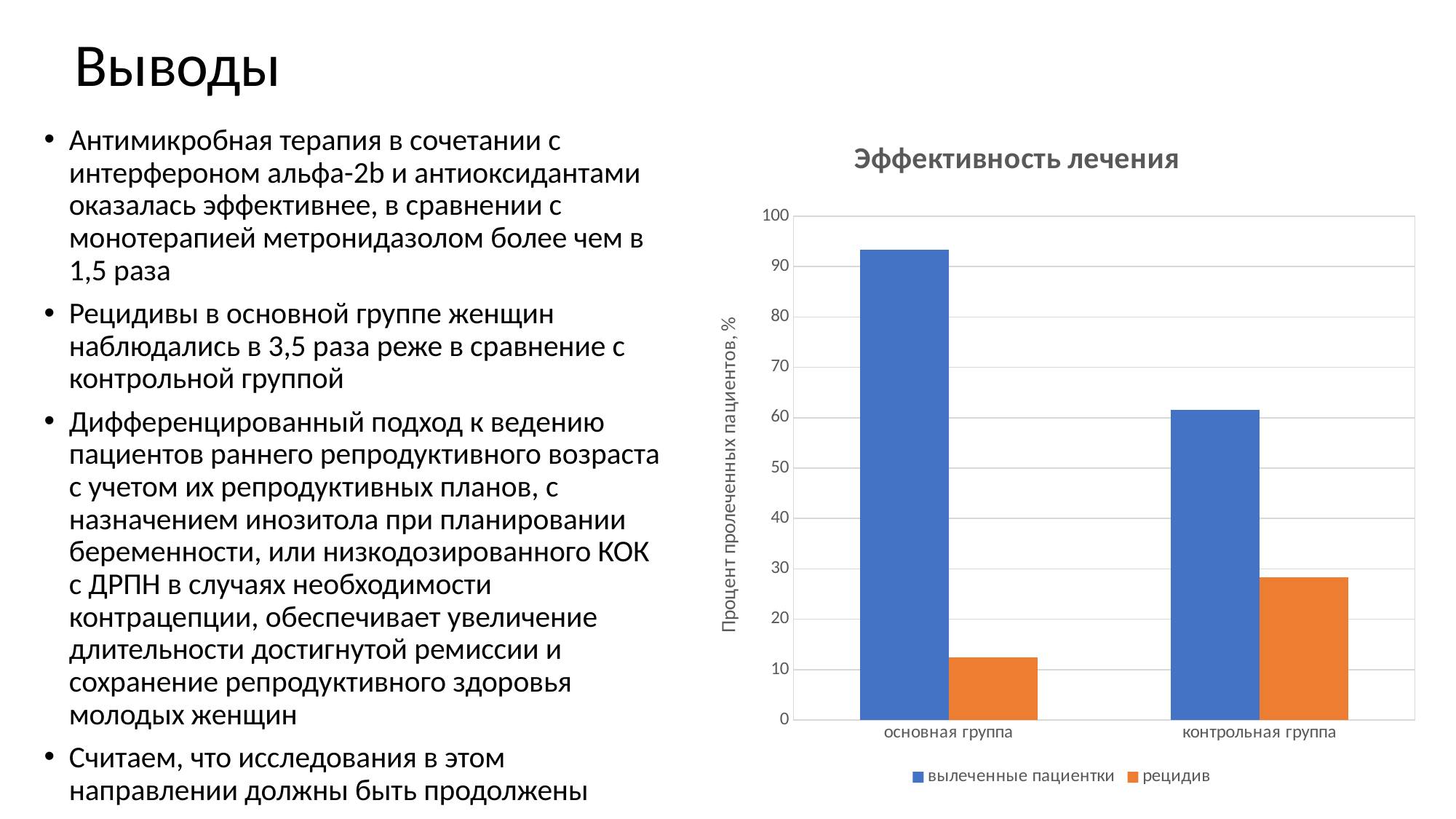
Is the value for вылеченные пациентки in основная группа greater or less than 80? greater How many categories are shown on the x axis of the chart? 2 Which bar in the chart is the tallest? вылеченные пациентки, основная группа Which group has the higher value for рецидив? контрольная группа What type of chart is shown on the slide? bar chart Which group has the higher value for вылеченные пациентки? основная группа How many series does the chart legend list? 2 Which series is shown in orange in the chart? рецидив What is the title of the chart? Эффективность лечения Is the value for вылеченные пациентки in контрольная группа greater or less than 50? greater Which bar in the chart is the shortest? рецидив, основная группа Is the value for рецидив in основная группа greater or less than 20? less